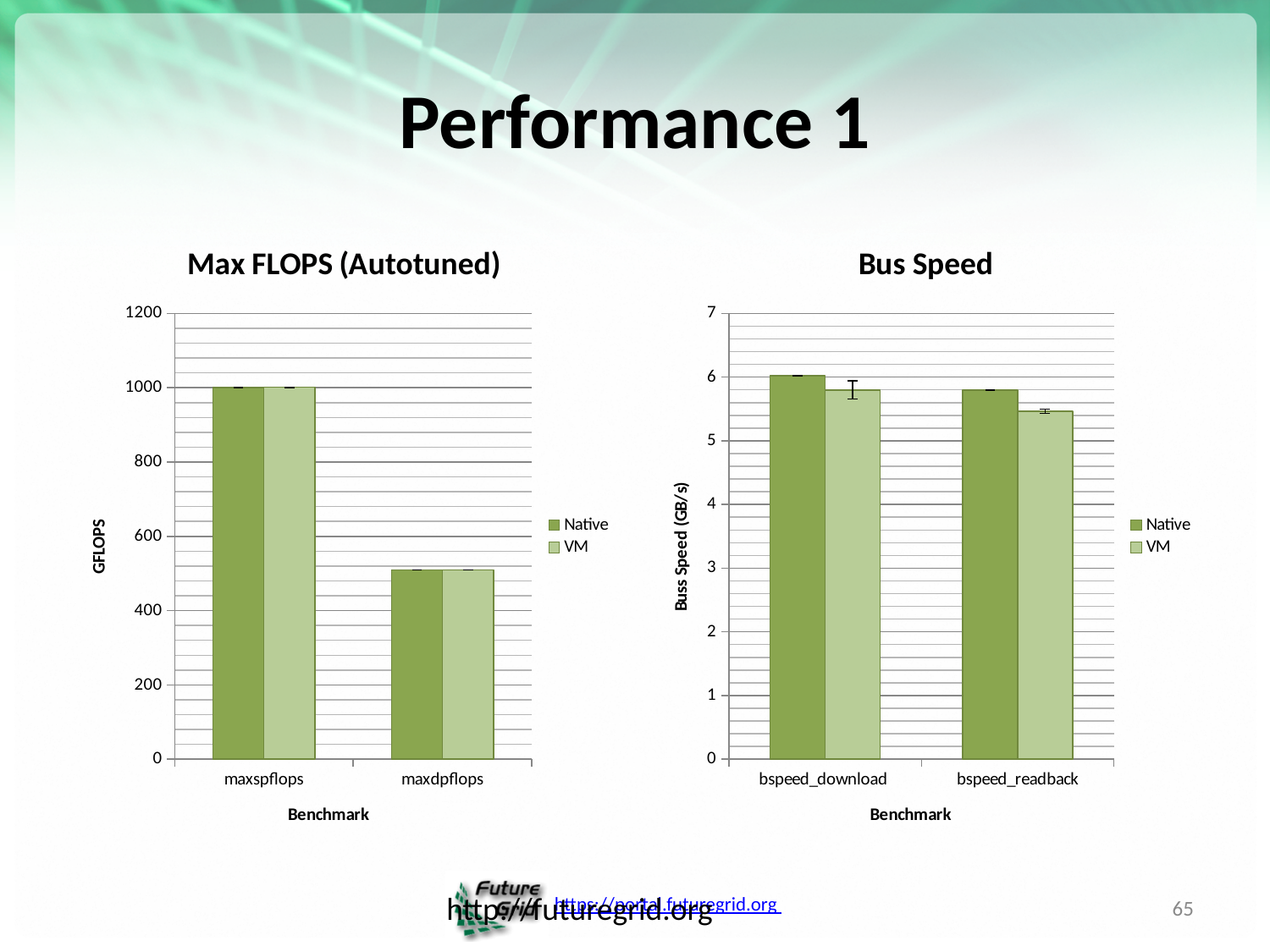
In the Max FLOPS (Autotuned) chart, how many benchmark categories are shown on the x axis? 2 In the Max FLOPS (Autotuned) chart, what is the label on the y axis? GFLOPS In the Bus Speed chart, is the Native value for bspeed_download greater or less than 5? greater In the Max FLOPS (Autotuned) chart, is the VM value for maxspflops greater or less than 800? greater In the Max FLOPS (Autotuned) chart, is the Native value for maxdpflops greater or less than 600? less In the Max FLOPS (Autotuned) chart, how many series does the legend list? 2 In the Max FLOPS (Autotuned) chart, which benchmark has the lowest VM value? maxdpflops In the Max FLOPS (Autotuned) chart, what kind of chart is shown? bar chart In the Max FLOPS (Autotuned) chart, which benchmark has the higher Native value? maxspflops In the Bus Speed chart, how many benchmark categories are shown on the x axis? 2 In the Bus Speed chart, which is larger: the Native value for bspeed_download or the VM value for bspeed_readback? Native value for bspeed_download